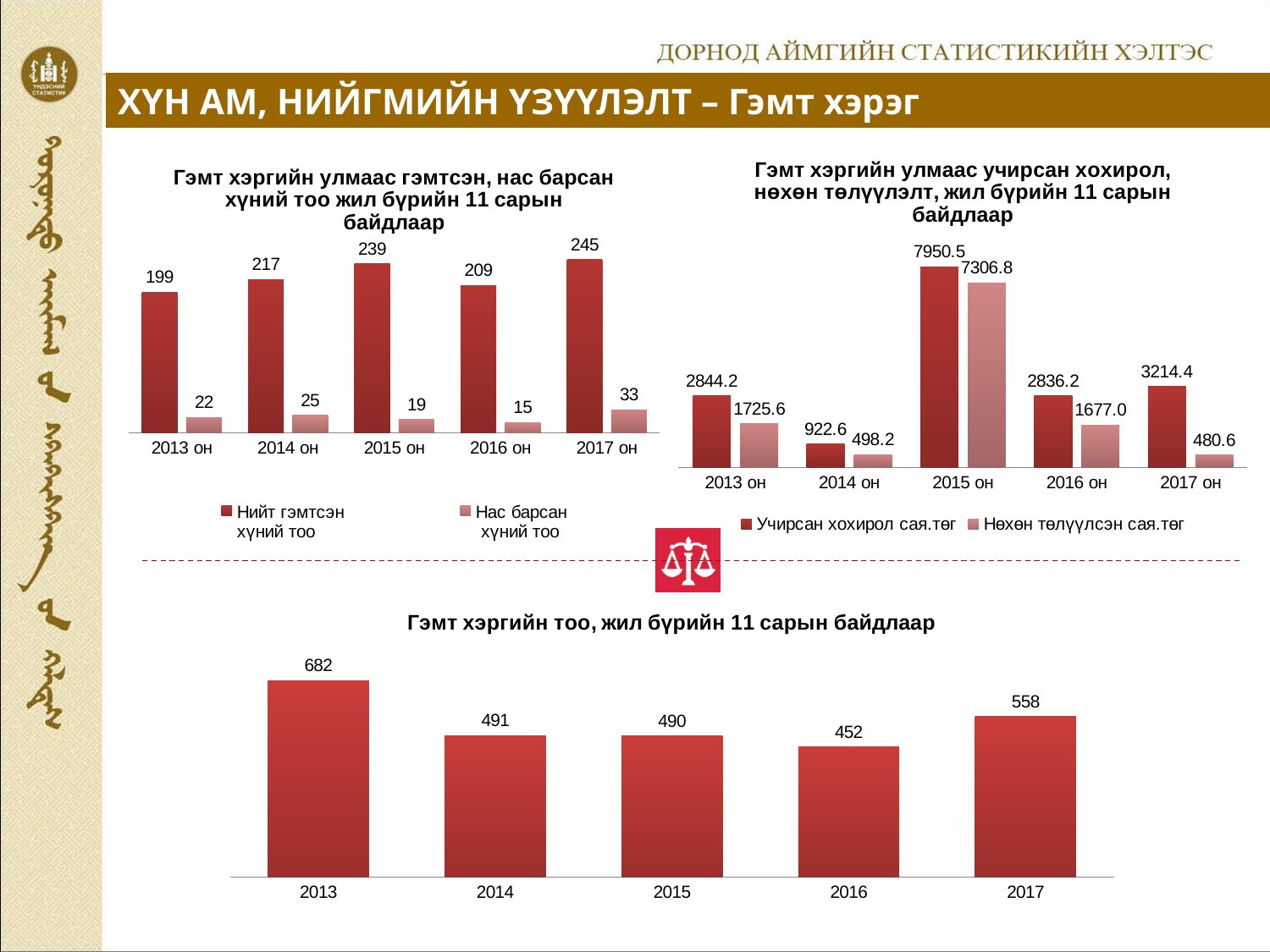
In the top-left chart, what is the value of 'Нийт гэмтсэн хүний тоо' for 2015 он? 239 In the top-left chart, what is the value of 'Нас барсан хүний тоо' for 2016 он? 15 In the bottom chart 'Гэмт хэргийн тоо, жил бүрийн 11 сарын байдлаар', what is the value for 2013? 682 In the bottom chart 'Гэмт хэргийн тоо, жил бүрийн 11 сарын байдлаар', how many years are shown on the x axis? 5 In the top-right chart, what is the value of 'Нөхөн төлүүлсэн сая.төг' for 2017 он? 480.6 In the top-left chart, which year has the highest value for 'Нас барсан хүний тоо'? 2017 он In the top-right chart, which is larger: 'Учирсан хохирол сая.төг' for 2013 он or for 2016 он? 2013 он What kind of chart is the bottom chart 'Гэмт хэргийн тоо, жил бүрийн 11 сарын байдлаар'? Bar chart In the top-right chart, what is the value of 'Учирсан хохирол сая.төг' for 2015 он? 7950.5 In the top-left chart, how many series does the legend list? 2 In the bottom chart 'Гэмт хэргийн тоо, жил бүрийн 11 сарын байдлаар', which year has the lowest value? 2016 In the bottom chart 'Гэмт хэргийн тоо, жил бүрийн 11 сарын байдлаар', what is the difference between the values for 2013 and 2017? 124